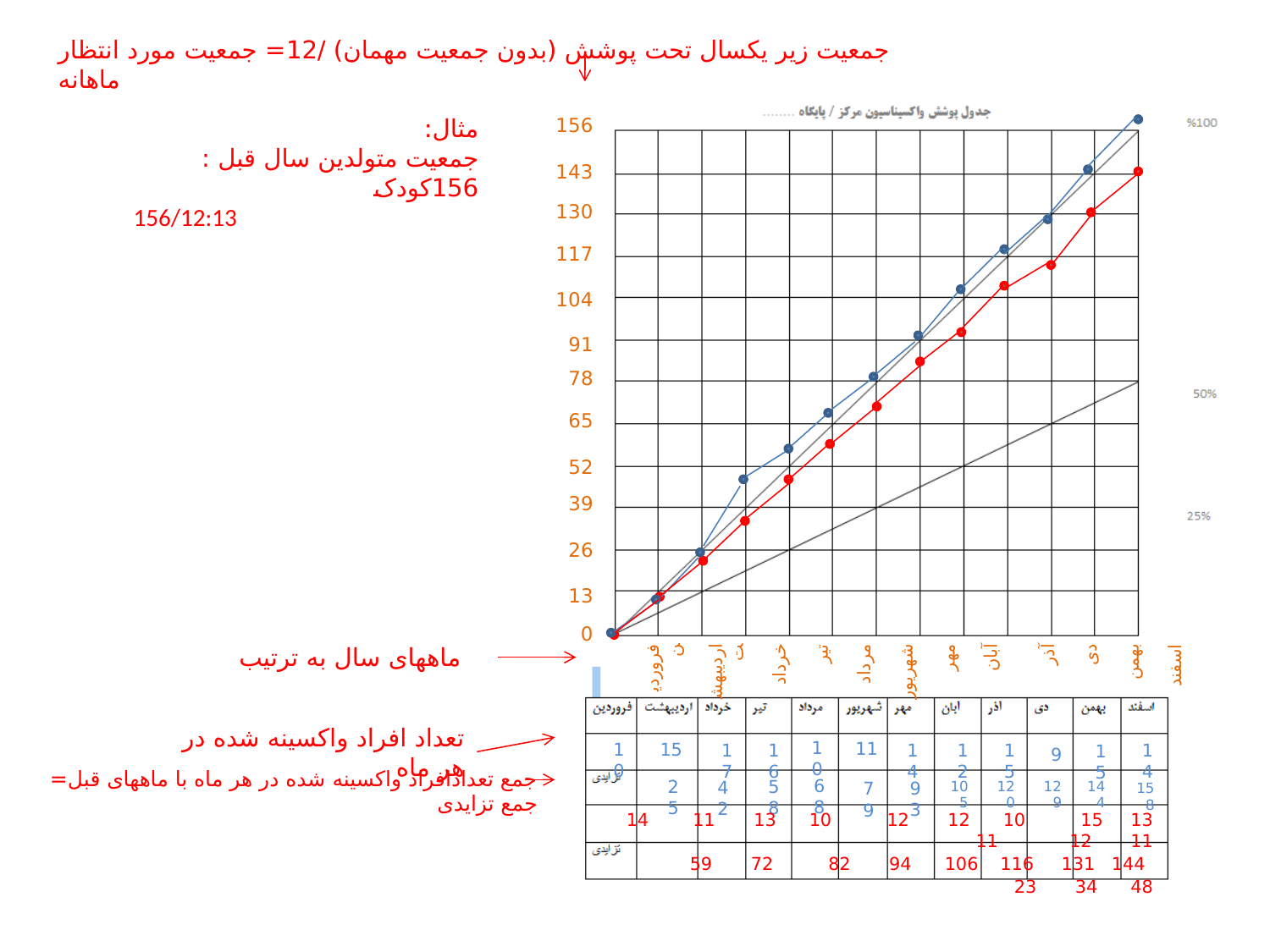
What is the starting value of both lines at the left edge of the chart? 0 Do the values of the blue and red lines rise or fall from left to right along the x axis? rise Is the highest value of the blue line greater or less than 143? greater Is the highest value of the red line greater or less than 130? greater What is the value of the blue line at its final (highest) point? 156 At the last month on the x axis, which line is higher, the blue line or the red line? blue line What is the value of the red line at its final point? 143 How many months are labelled along the x axis of the chart? 12 What kind of chart is shown on the slide? line chart What percentage labels are shown on the right side of the chart? 100%, 50%, 25% What is the highest tick value shown on the left y axis? 156